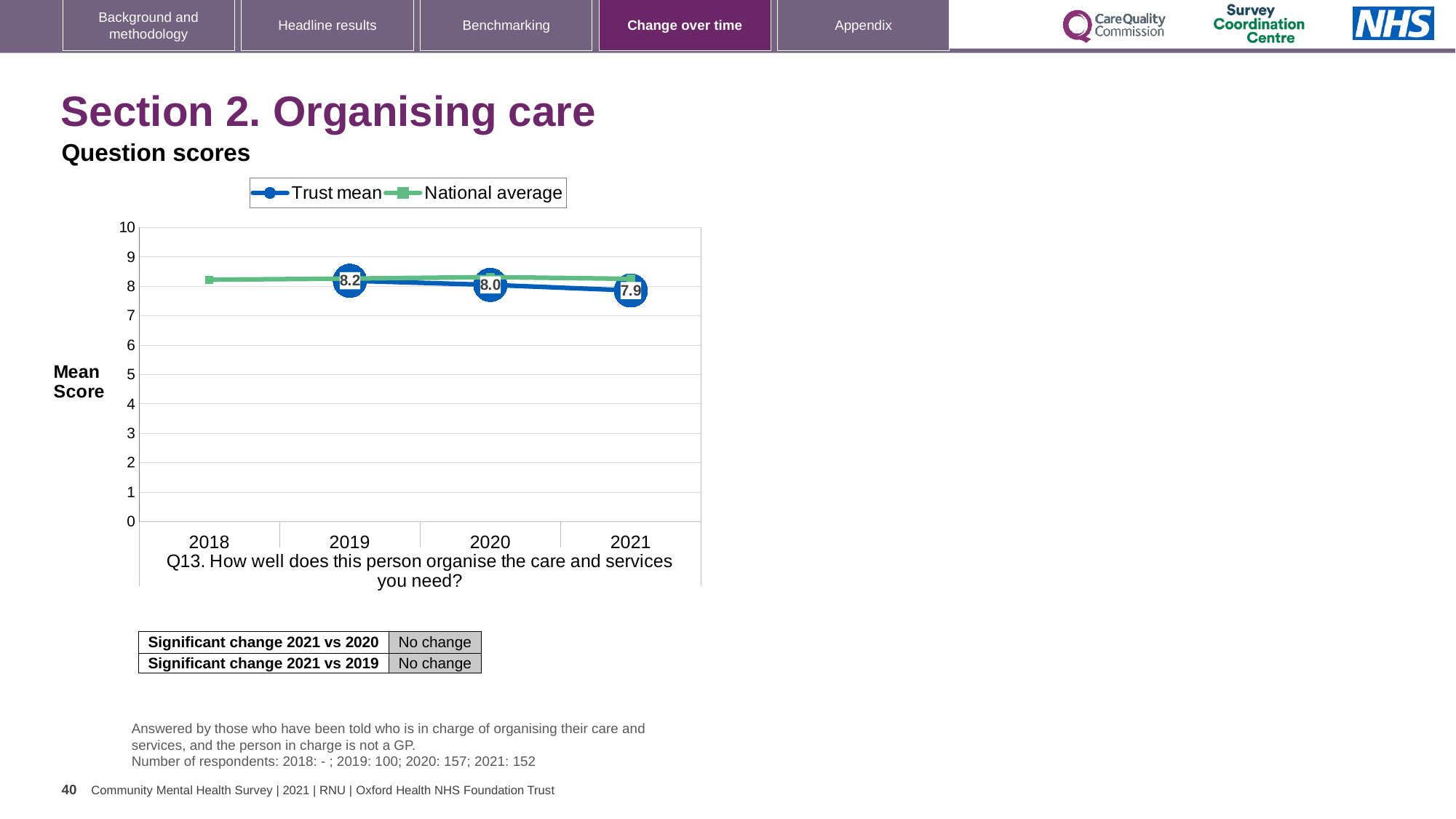
What is the Trust mean score for 2020? 8.0 How many series does the legend list? 2 In which year is the Trust mean score lowest? 2021 What is the Trust mean score for 2021? 7.9 In which year is the Trust mean score highest? 2019 Is the National average value for 2018 greater or less than 7? greater What kind of chart is shown on the slide? Line chart What is the label on the y axis of the chart? Mean Score What is the difference between the Trust mean score in 2019 and in 2021? 0.3 Does the Trust mean score rise or fall from 2019 to 2021? Fall Which is larger, the Trust mean score in 2019 or in 2020? 2019 What is the Trust mean score for 2019? 8.2